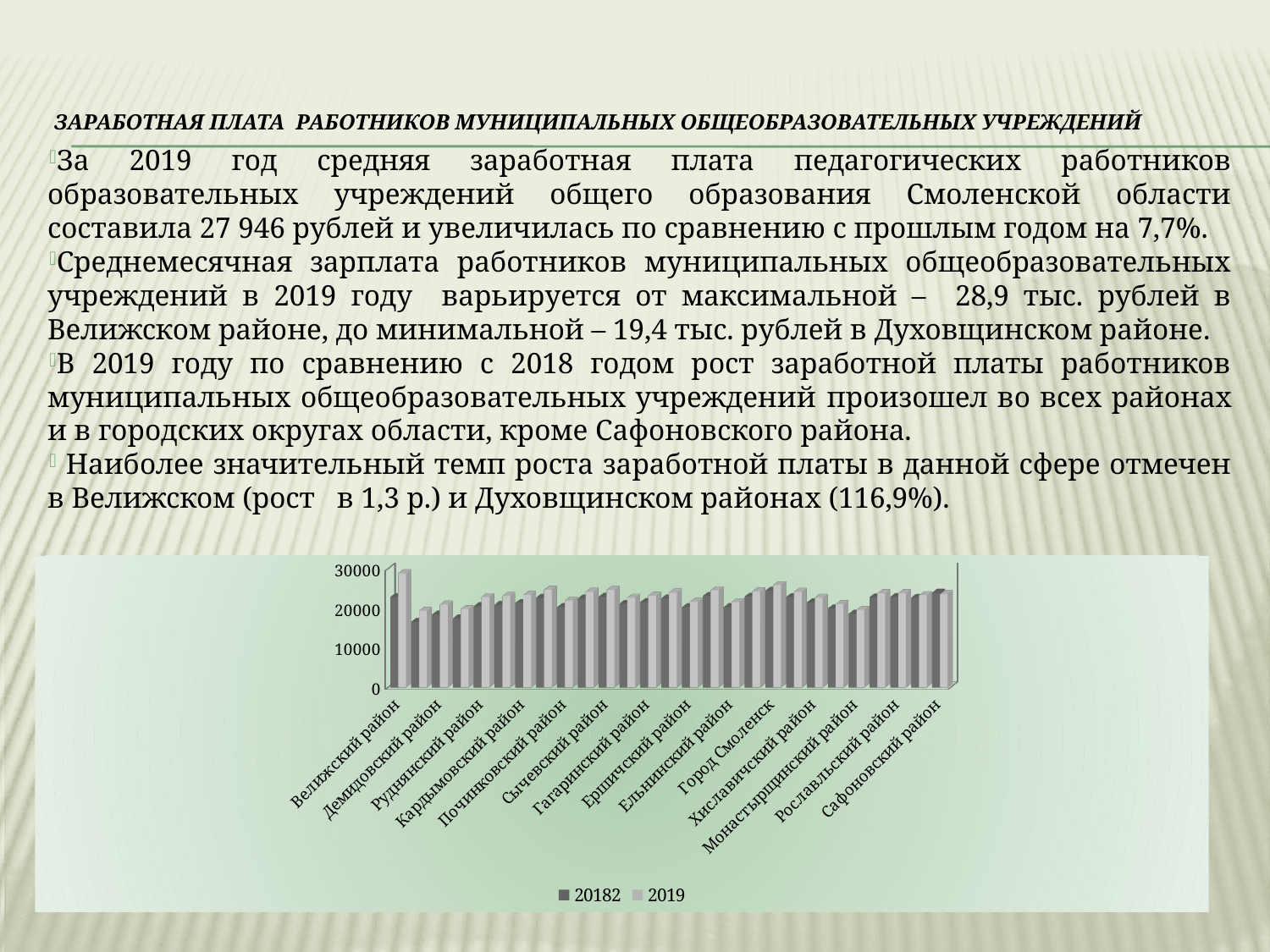
Is the 2019 value for Город Смоленск greater or less than 10000? greater Is the 2019 value for Велижский район greater or less than 30000? less How many series does the chart legend list? 2 Is the 2019 value for Сафоновский район greater or less than 30000? less What kind of chart is shown on the slide? bar chart What are the two series named in the chart legend? 20182 and 2019 What is the highest tick value shown on the vertical axis of the chart? 30000 Which district has the highest 2019 value in the chart? Велижский район For Велижский район, which series has the larger value, 20182 or 2019? 2019